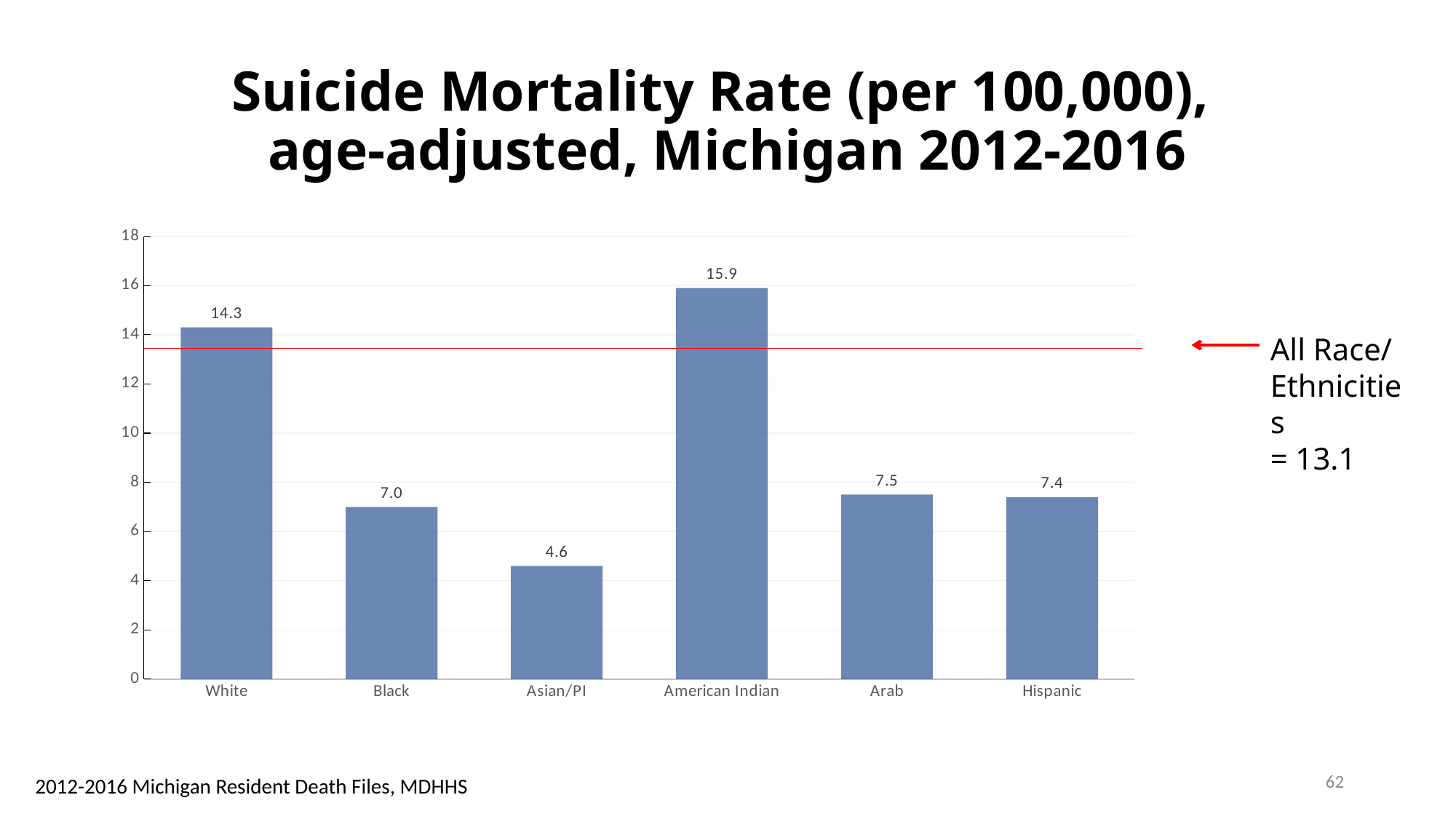
What kind of chart is shown on the slide? bar chart What is the suicide mortality rate for White? 14.3 Which group has the highest suicide mortality rate? American Indian Is the value for Hispanic greater or less than 8? less Which has a higher suicide mortality rate, Black or Hispanic? Hispanic How many race/ethnicity groups are shown on the chart? 6 Which group has the lowest suicide mortality rate? Asian/PI What is the difference between the suicide mortality rates for American Indian and White? 1.6 What is the suicide mortality rate for Asian/PI? 4.6 What is the difference between the suicide mortality rates for Black and Asian/PI? 2.4 What value does the red horizontal line on the chart represent? All Race/Ethnicities = 13.1 What is the suicide mortality rate for Arab? 7.5